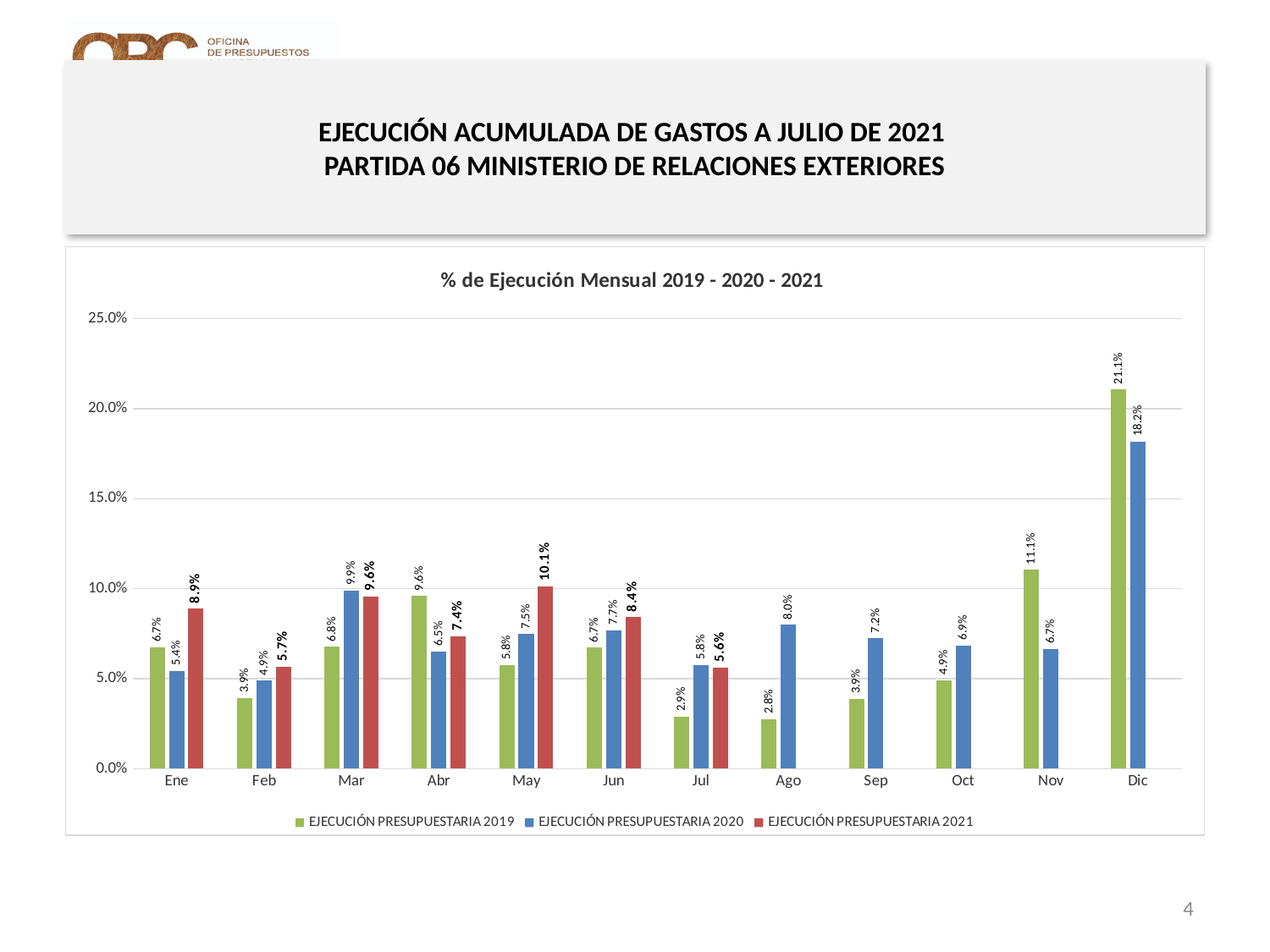
Is the value for EJECUCIÓN PRESUPUESTARIA 2019 in Nov greater or less than 10.0%? greater What kind of chart is shown on the slide? Bar chart What is the title of the chart? % de Ejecución Mensual 2019 - 2020 - 2021 Which month has the lowest value for EJECUCIÓN PRESUPUESTARIA 2019? Ago What is the difference between the 2019 and 2020 values in Dic? 2.9% What is the value for EJECUCIÓN PRESUPUESTARIA 2021 in May? 10.1% How many months are shown on the x axis? 12 How many series does the legend list? 3 What is the value for EJECUCIÓN PRESUPUESTARIA 2020 in Ago? 8.0% In Abr, which series has the larger value, EJECUCIÓN PRESUPUESTARIA 2019 or EJECUCIÓN PRESUPUESTARIA 2020? EJECUCIÓN PRESUPUESTARIA 2019 What is the value for EJECUCIÓN PRESUPUESTARIA 2019 in Dic? 21.1% Which month has the highest value for EJECUCIÓN PRESUPUESTARIA 2021? May